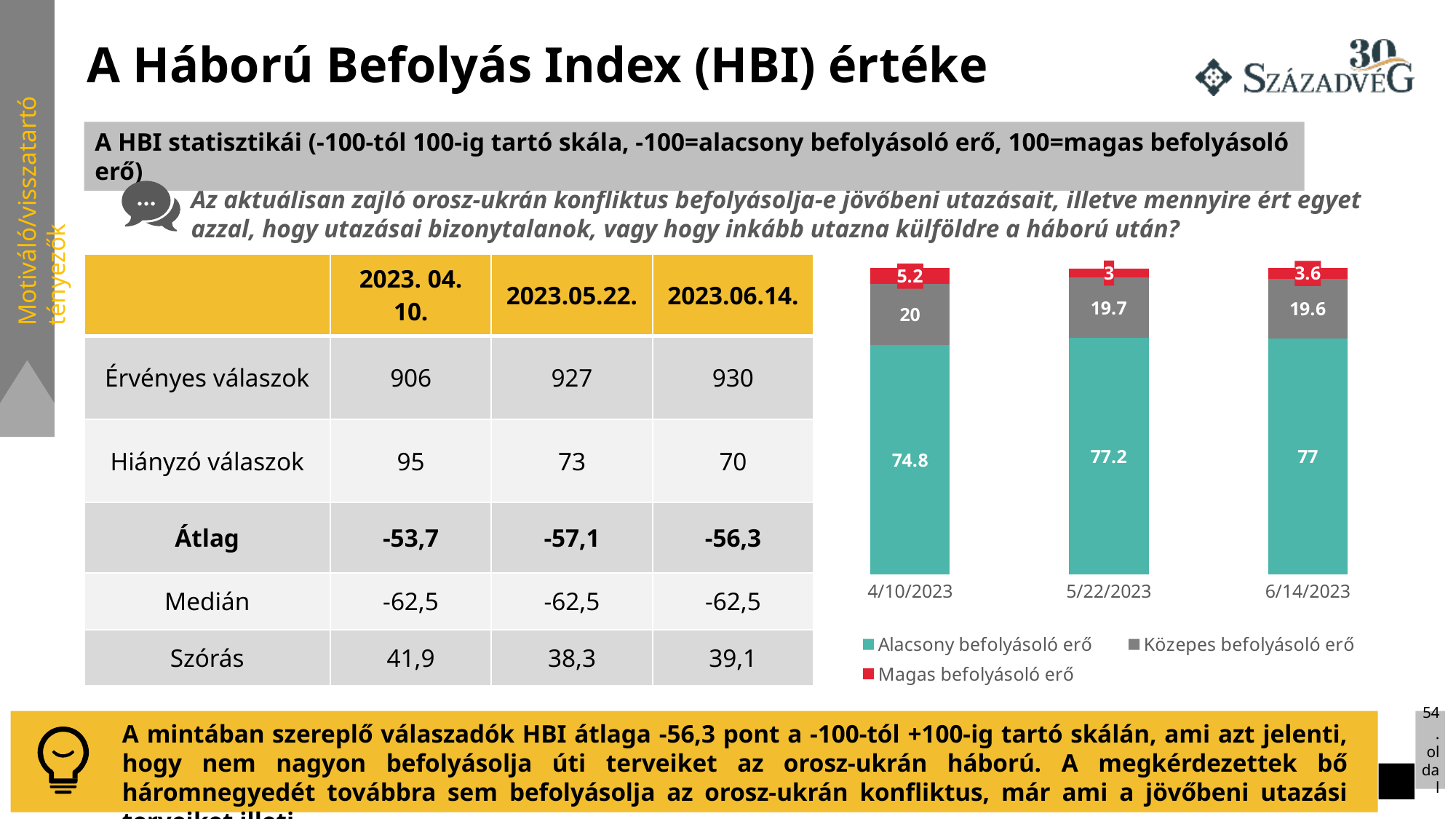
What is the value of "Magas befolyásoló erő" for 6/14/2023? 3.6 Which is larger: the "Magas befolyásoló erő" value for 4/10/2023 or for 6/14/2023? 4/10/2023 What kind of chart is shown on the slide? Stacked bar chart What is the value of "Közepes befolyásoló erő" for 5/22/2023? 19.7 How many dates (categories) are shown on the x axis of the chart? 3 On which date is the "Alacsony befolyásoló erő" value highest? 5/22/2023 On which date is the "Magas befolyásoló erő" value lowest? 5/22/2023 What is the value of "Alacsony befolyásoló erő" for 4/10/2023? 74.8 How many series does the chart legend list? 3 Which series is shown in red in the chart? Magas befolyásoló erő What is the total of the stacked bar for 4/10/2023? 100 What is the difference between the "Alacsony befolyásoló erő" values for 5/22/2023 and 4/10/2023? 2.4